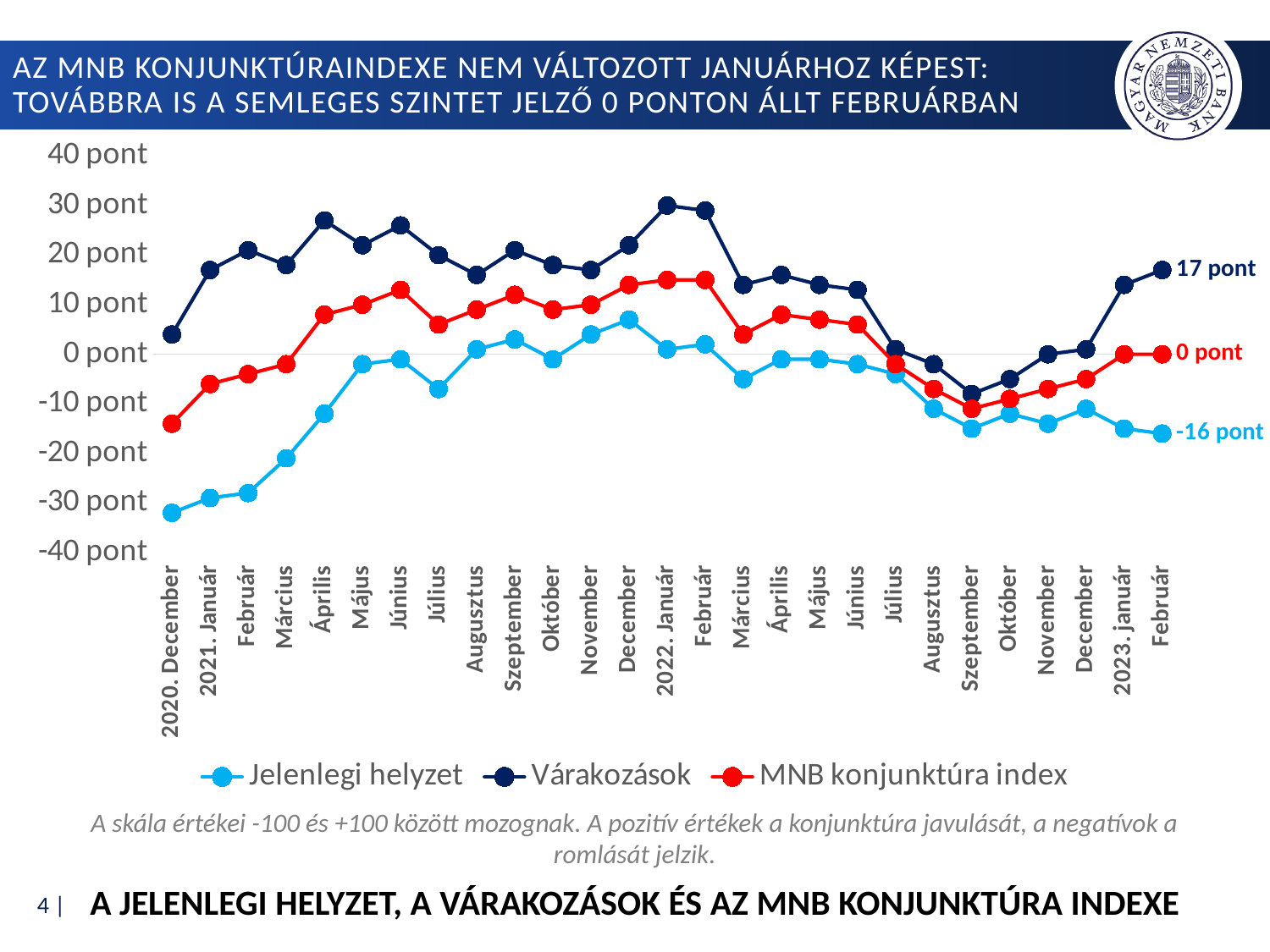
Does Jelenlegi helyzet rise or fall from 2020. December to 2021. Június? Rise In 2022. Január, which is larger: Várakozások or the MNB konjunktúra index? Várakozások What kind of chart is shown on the slide? Line chart What is the value of Várakozások in 2023. Február? 17 pont Which series has the lowest value in 2023. Február? Jelenlegi helyzet Which series has the highest value in 2023. Február? Várakozások How many series does the legend list? 3 What is the value of the MNB konjunktúra index in 2023. Február? 0 pont Is the value of Jelenlegi helyzet in 2020. December greater or less than -30 pont? less What is the value of Jelenlegi helyzet in 2023. Február? -16 pont Is the value of Várakozások in 2022. Január greater or less than 20 pont? greater What is the difference between Várakozások and Jelenlegi helyzet in 2023. Február? 33 pont